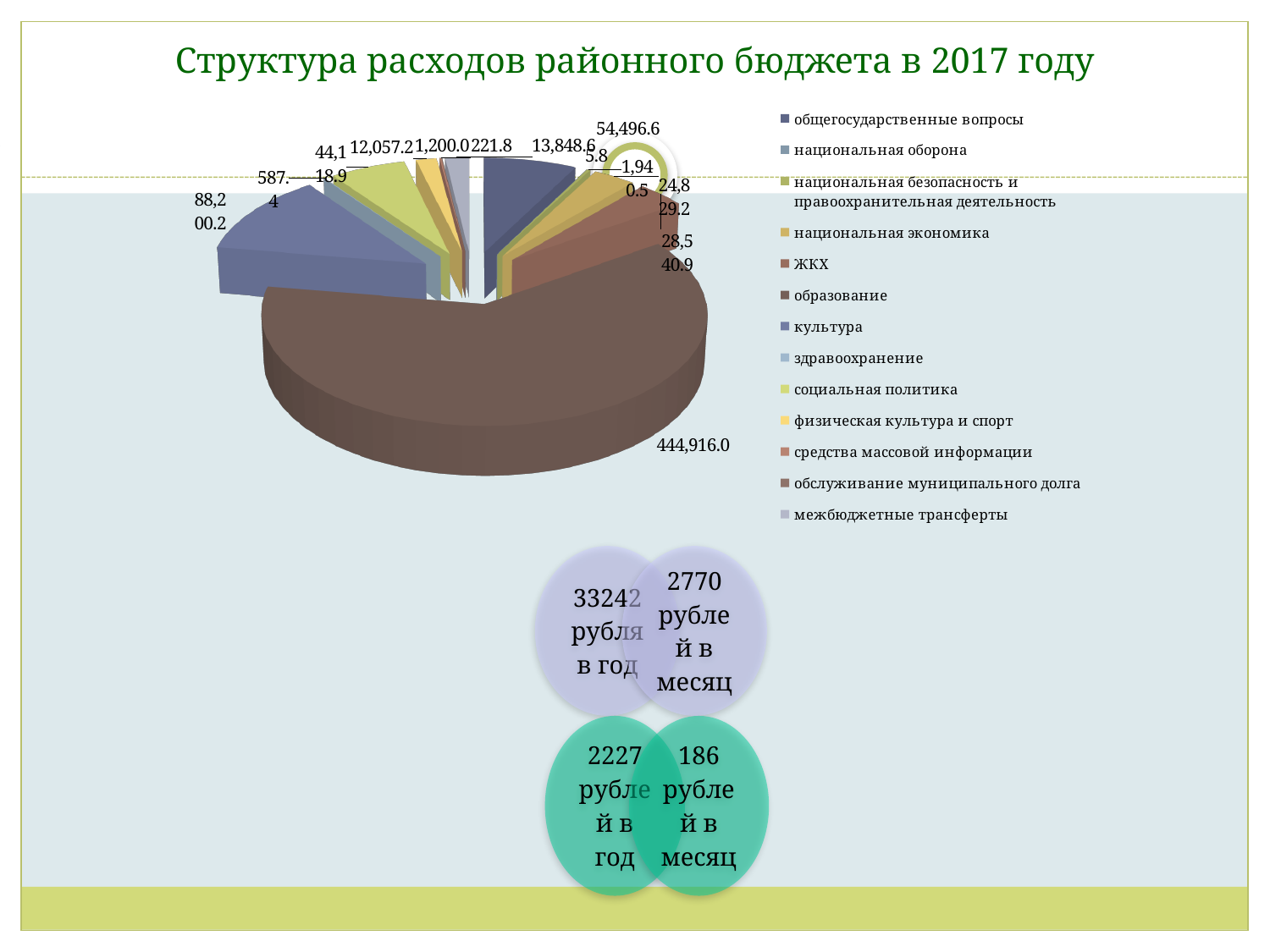
Which category has the largest slice of the pie chart? образование What is the first category listed in the legend? общегосударственные вопросы What is the value shown for общегосударственные вопросы? 54,496.6 What is the value shown for образование? 444,916.0 What is the title of the chart? Структура расходов районного бюджета в 2017 году Which is larger, the slice for культура or the slice for общегосударственные вопросы? культура Is the value for образование greater or less than 400,000? greater How many categories does the legend of the pie chart list? 13 Which is larger, the slice for образование or the slice for культура? образование What kind of chart is shown on the slide? pie chart